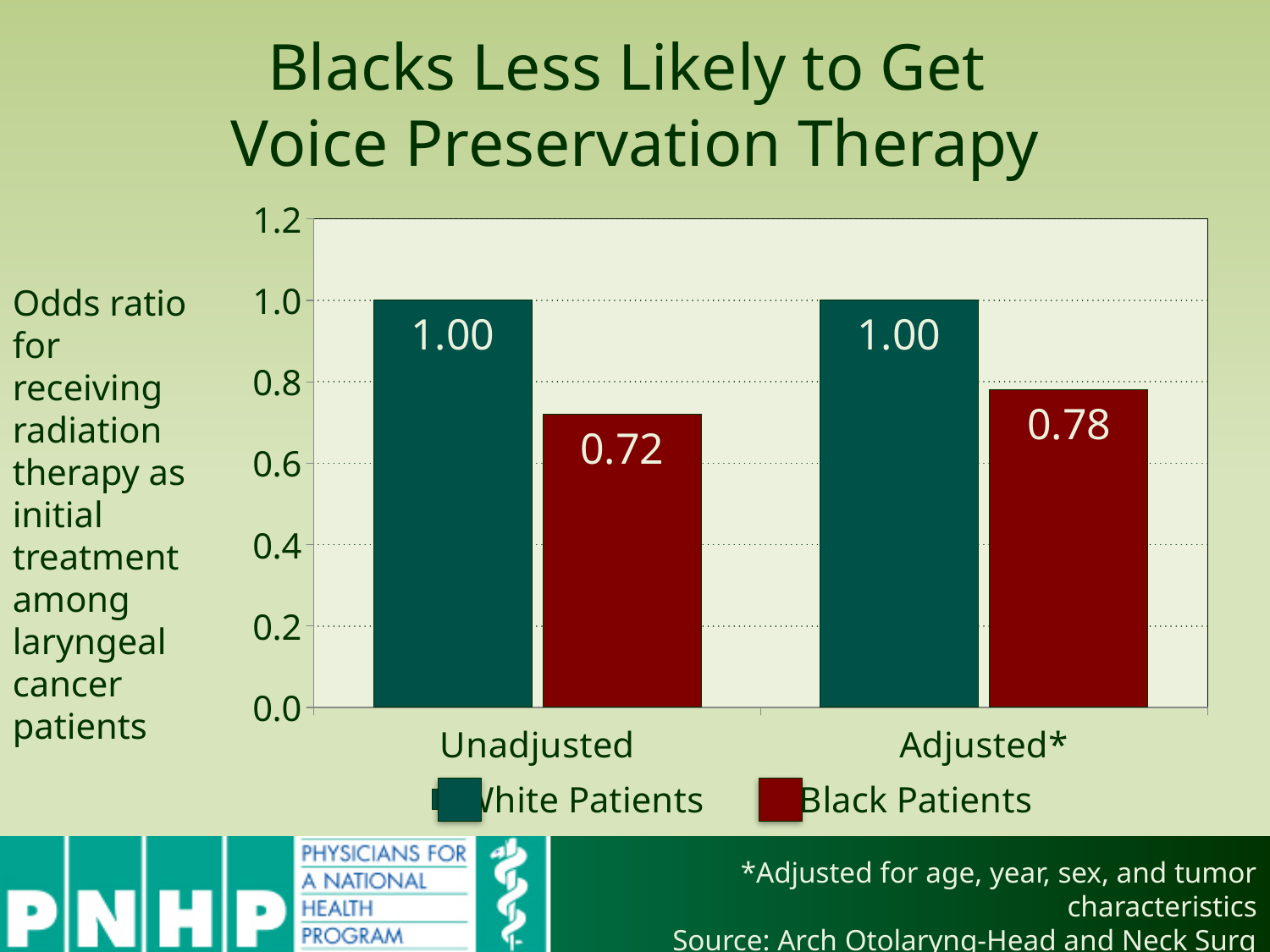
What kind of chart is shown on the slide? bar chart What is the difference between the White Patients and Black Patients values in the Unadjusted group? 0.28 Which series is shown in dark red? Black Patients What is the odds ratio for White Patients in the Adjusted* group? 1.00 What is the odds ratio for Black Patients in the Adjusted* group? 0.78 What is the odds ratio for White Patients in the Unadjusted group? 1.00 How many categories are shown on the x axis? 2 Is the value for Black Patients in the Unadjusted group greater or less than 0.8? less How many series does the legend list? 2 What is the difference between the White Patients and Black Patients values in the Adjusted* group? 0.22 Which is larger for Black Patients: the Unadjusted value or the Adjusted* value? Adjusted* What is the odds ratio for Black Patients in the Unadjusted group? 0.72